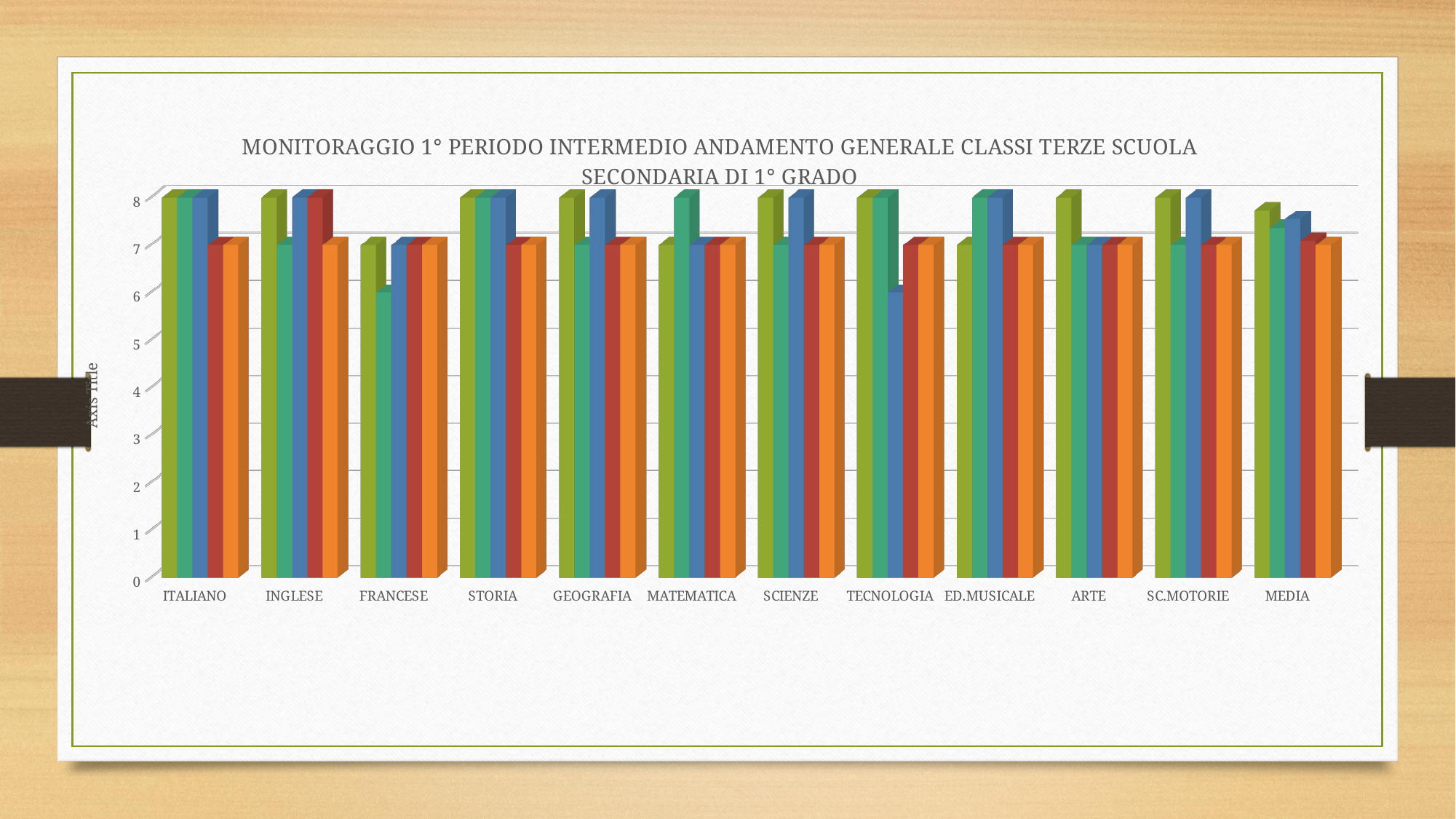
What kind of chart is shown on the slide? bar chart How many categories are shown along the x axis of the chart? 12 What is the title of the chart? MONITORAGGIO 1° PERIODO INTERMEDIO ANDAMENTO GENERALE CLASSI TERZE SCUOLA SECONDARIA DI 1° GRADO Is the shortest bar for FRANCESE greater or less than 7? less What is the highest value shown on the vertical axis of the chart? 8 What is the lowest bar value in the TECNOLOGIA category? 6 Is the shortest bar for STORIA greater or less than 6? greater Is the tallest bar for MEDIA greater or less than 7? greater What is the highest bar value in the ITALIANO category? 8 What is the lowest bar value in the FRANCESE category? 6 What is the highest bar value in the ARTE category? 8 Which category is the last one on the x axis of the chart? MEDIA